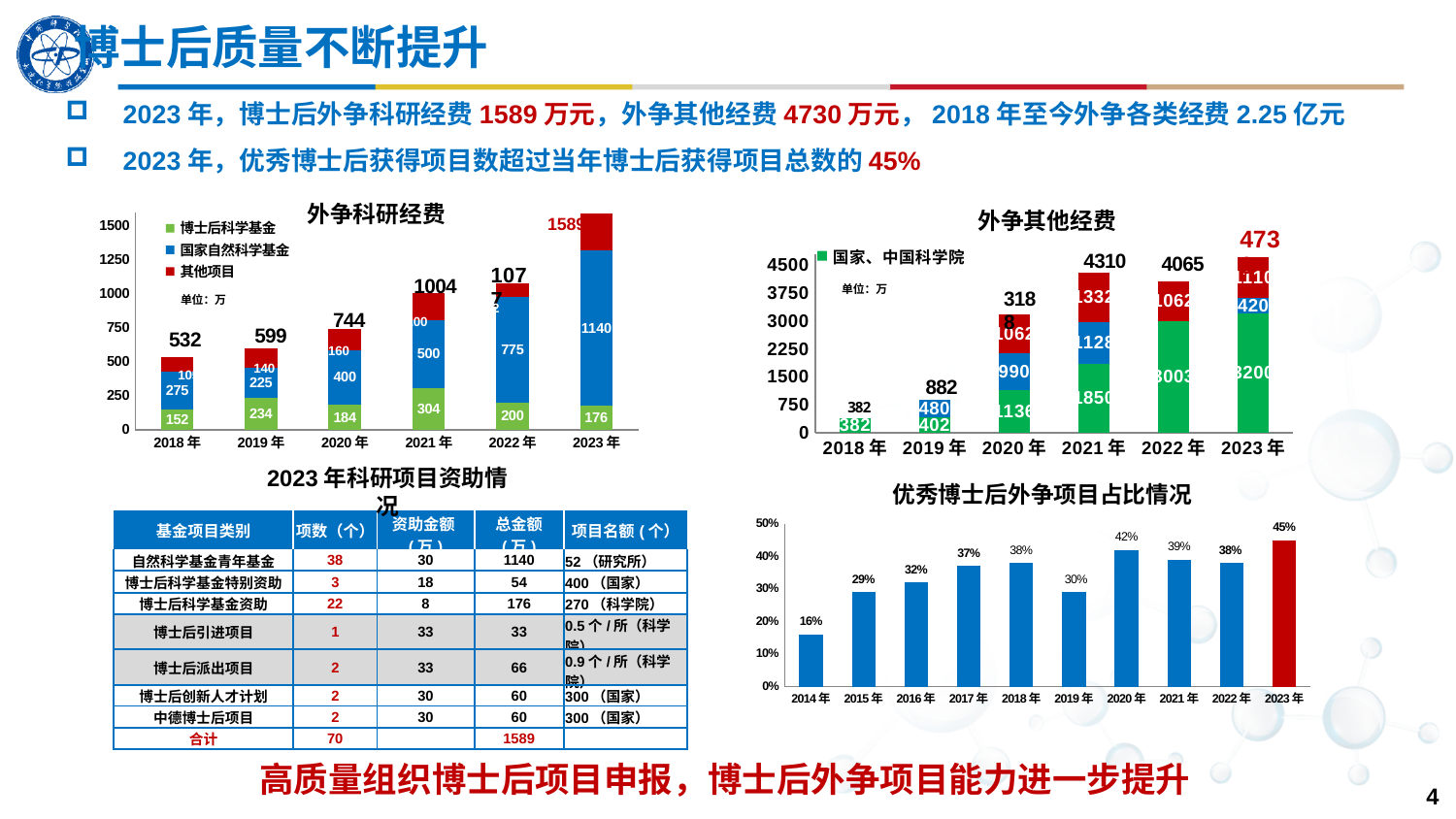
In the 外争科研经费 chart, what is the total for 2021年? 1004 How many series does the legend of the 外争科研经费 chart list? 3 What kind of chart is the 优秀博士后外争项目占比情况 chart? bar chart In the 外争科研经费 chart, what is the 博士后科学基金 value for 2021年? 304 In the 优秀博士后外争项目占比情况 chart, what is the value for 2014年? 16% In the 外争其他经费 chart, which year has the larger total, 2021年 or 2022年? 2021年 In the 优秀博士后外争项目占比情况 chart, what is the difference between the values for 2023年 and 2014年? 29% In the 优秀博士后外争项目占比情况 chart, which year has the lowest value? 2014年 In the 优秀博士后外争项目占比情况 chart, which year has the highest value? 2023年 How many years are shown in the 优秀博士后外争项目占比情况 chart? 10 In the 外争科研经费 chart, what is the 国家自然科学基金 value for 2023年? 1140 In the 外争其他经费 chart, what is the total for 2021年? 4310